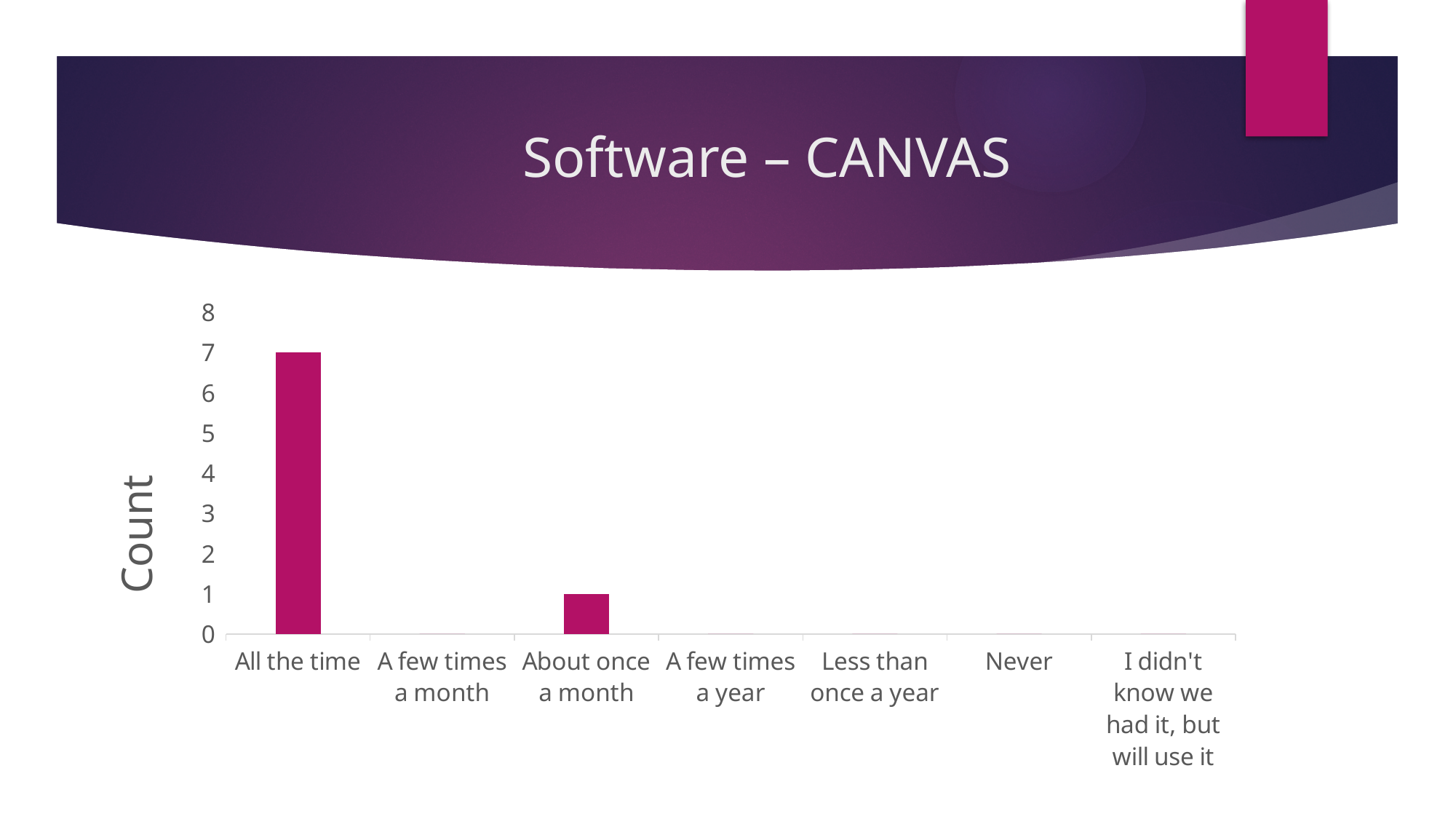
What is the label of the vertical axis? Count How many categories are shown on the x axis? 7 Is the count for "All the time" greater or less than 5? greater Which category has the highest count? All the time What is the highest value shown on the vertical axis? 8 What is the count for "About once a month"? 1 What is the difference between the counts for "All the time" and "About once a month"? 6 Which is larger, the count for "All the time" or the count for "About once a month"? All the time What type of chart is shown on the slide? bar chart What is the title of the slide containing the chart? Software – CANVAS Is the count for "About once a month" greater or less than 4? less What is the count for "All the time"? 7